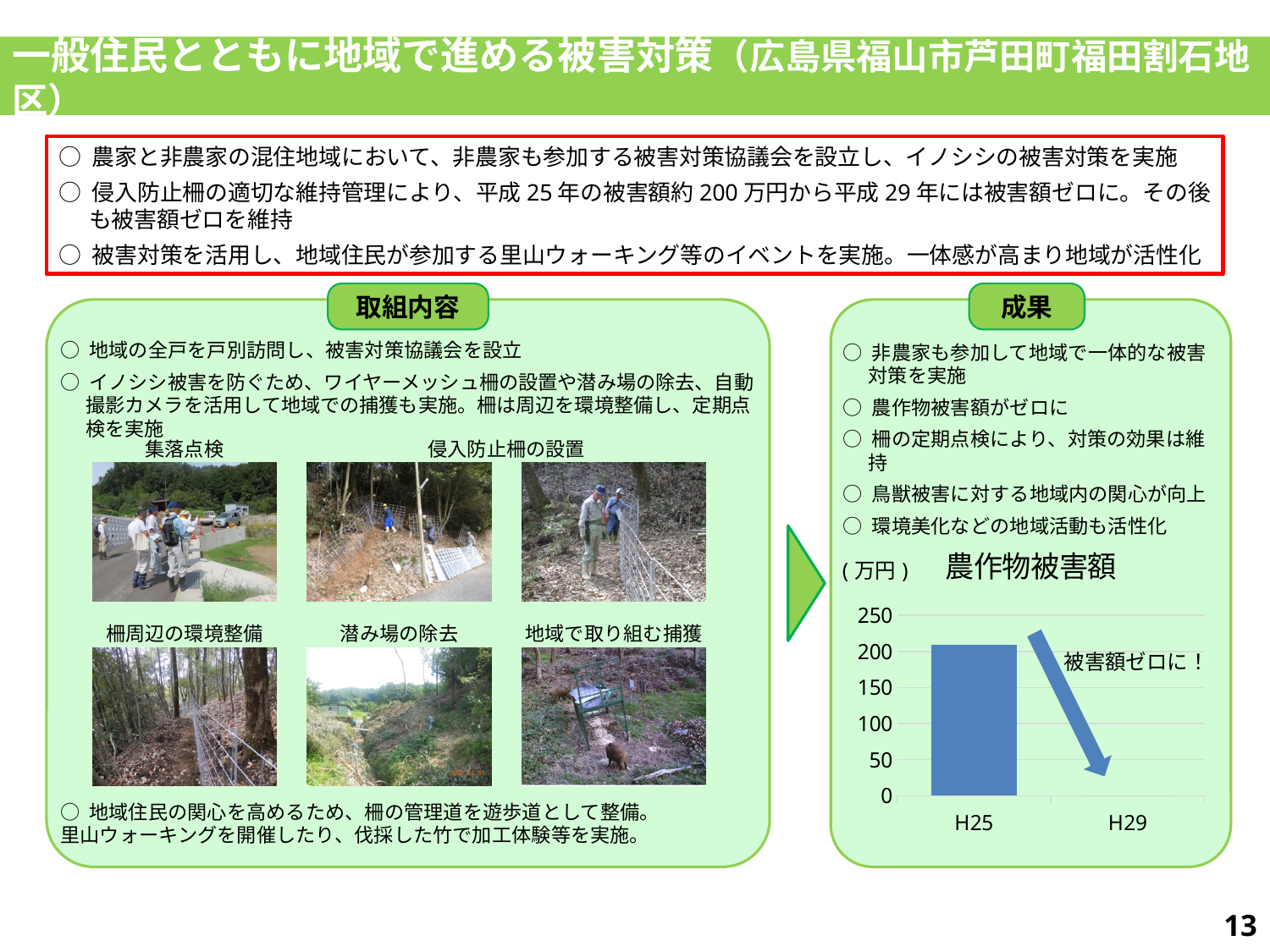
Which category has the lowest value in the 農作物被害額 chart? H29 What is the highest tick value on the y axis of the 農作物被害額 chart? 250 In the 農作物被害額 chart, is the value for H25 greater or less than 150? greater How many categories are shown on the x axis of the 農作物被害額 chart? 2 What is the value for H29 in the 農作物被害額 chart? 0 In the 農作物被害額 chart, is the value for H25 greater or less than 100? greater Do the values in the 農作物被害額 chart rise or fall from H25 to H29? fall In the 農作物被害額 chart, which is larger, the value for H25 or the value for H29? H25 Which category has the highest value in the 農作物被害額 chart? H25 What unit is shown next to the 農作物被害額 chart? 万円 What kind of chart is shown under the heading 農作物被害額? bar chart In the 農作物被害額 chart, is the value for H25 greater or less than 250? less